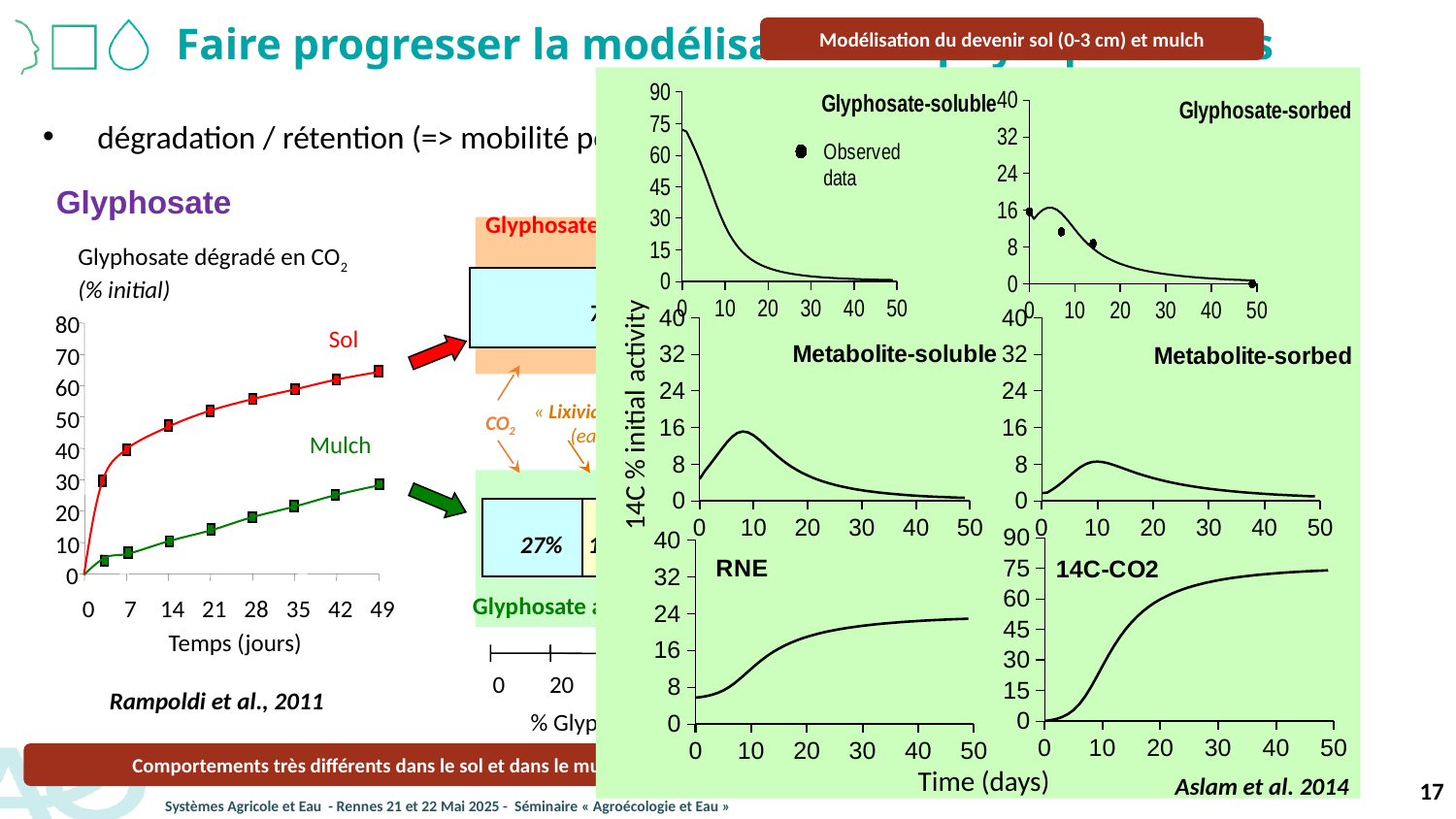
In the '14C-CO2' chart on the right panel, is the value at day 50 greater or less than 60? greater In the left chart 'Glyphosate dégradé en CO2 (% initial)', is the value for Sol at 49 days greater or less than 60? greater In the 'Glyphosate-soluble' chart on the right panel, is the value at day 0 greater or less than 60? greater In the left chart 'Glyphosate dégradé en CO2 (% initial)', which series has the higher value at 49 days, Sol or Mulch? Sol In the left chart 'Glyphosate dégradé en CO2 (% initial)', how many series are plotted? 2 In the left chart 'Glyphosate dégradé en CO2 (% initial)', do the values for Mulch rise or fall as time increases? rise In the left chart 'Glyphosate dégradé en CO2 (% initial)', what is the label of the x axis? Temps (jours) How many small charts are shown in the green panel on the right ('Modélisation du devenir sol (0-3 cm) et mulch')? 6 In the left chart 'Glyphosate dégradé en CO2 (% initial)', what kind of chart is it? line chart In the 'Glyphosate-soluble' chart on the right panel, do the values rise or fall as time increases? fall In the '14C-CO2' chart on the right panel, do the values rise or fall as time increases? rise